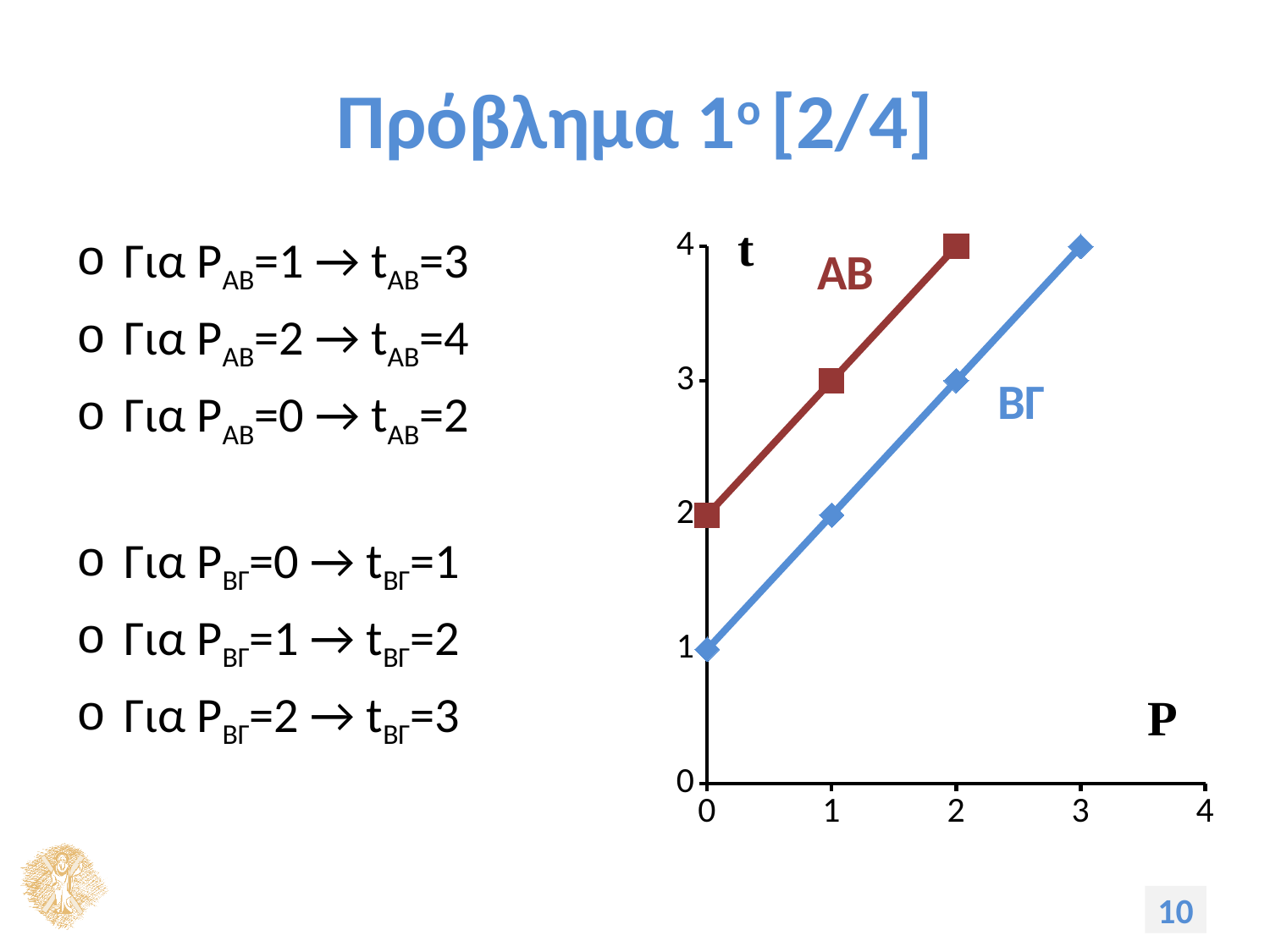
What is the value of t for series ΒΓ at P=0? 1 At P=2, which series has the higher t value, AB or ΒΓ? AB How many data points are plotted for series AB? 3 What is the value of t for series AB at P=1? 3 Do the t values of series AB rise or fall as P increases? rise What is the difference between the t values of AB and ΒΓ at P=1? 1 What is the value of t for series AB at P=0? 2 How many data points are plotted for series ΒΓ? 4 What label is shown on the vertical axis of the chart? t What kind of chart is shown on the slide? line chart How many series are plotted on the chart? 2 What is the value of t for series ΒΓ at P=3? 4